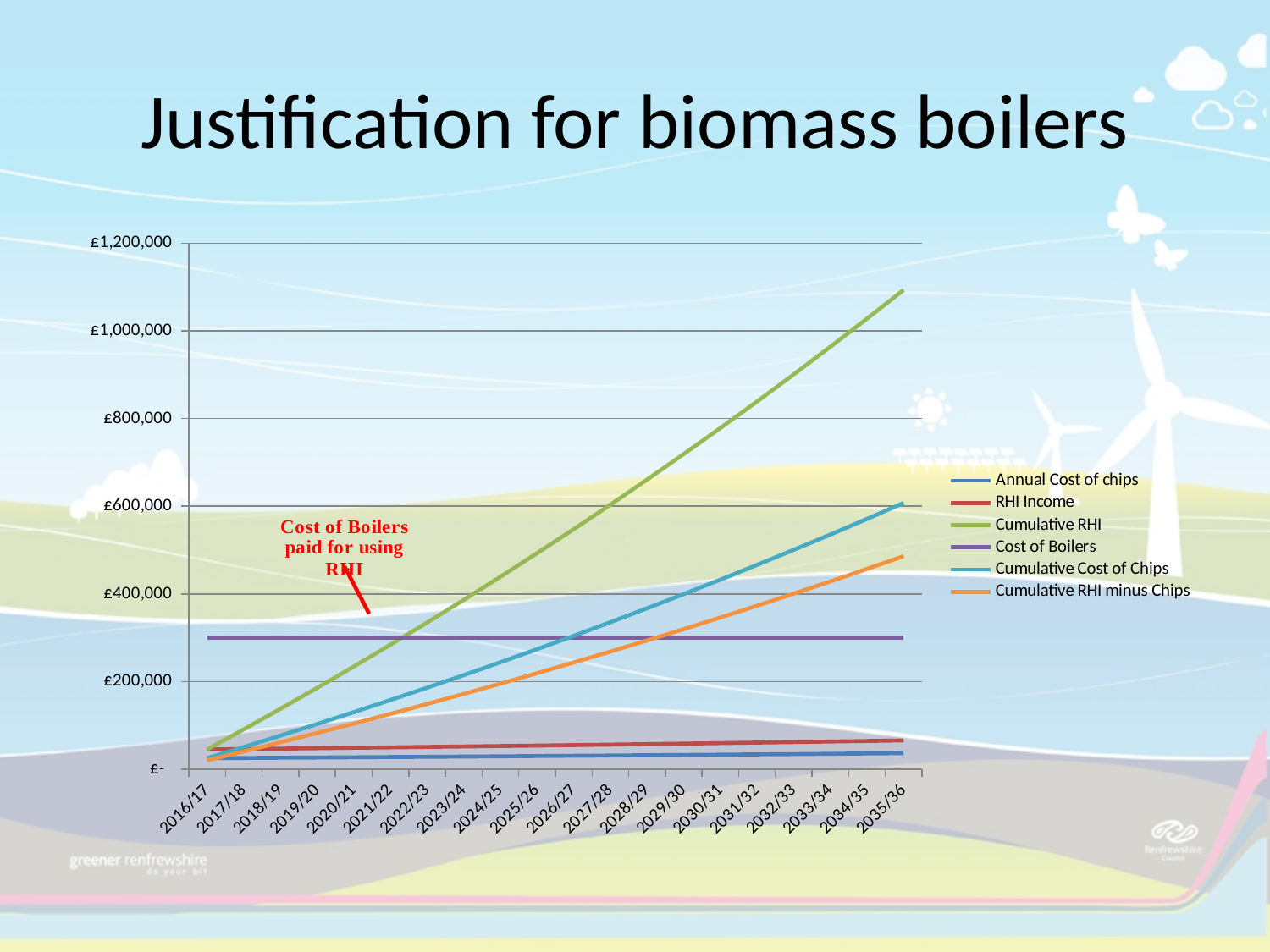
Which series has the highest value in 2035/36? Cumulative RHI Which series has the lowest value in 2035/36? Annual Cost of chips What does the red annotation on the chart say? Cost of Boilers paid for using RHI Is the value of Cumulative RHI in 2035/36 greater or less than £1,000,000? greater Is the value of Cumulative RHI minus Chips in 2035/36 greater or less than £400,000? greater Is the value of Cost of Boilers greater or less than £400,000? less How many series does the legend list? 6 Does the Cumulative RHI line rise or fall from 2016/17 to 2035/36? Rises How many years are shown along the x axis? 20 What kind of chart is shown on the slide? Line chart In 2035/36, which is larger: Cumulative RHI or Cumulative Cost of Chips? Cumulative RHI Does the Cost of Boilers line rise, fall or stay flat across the years? Stays flat